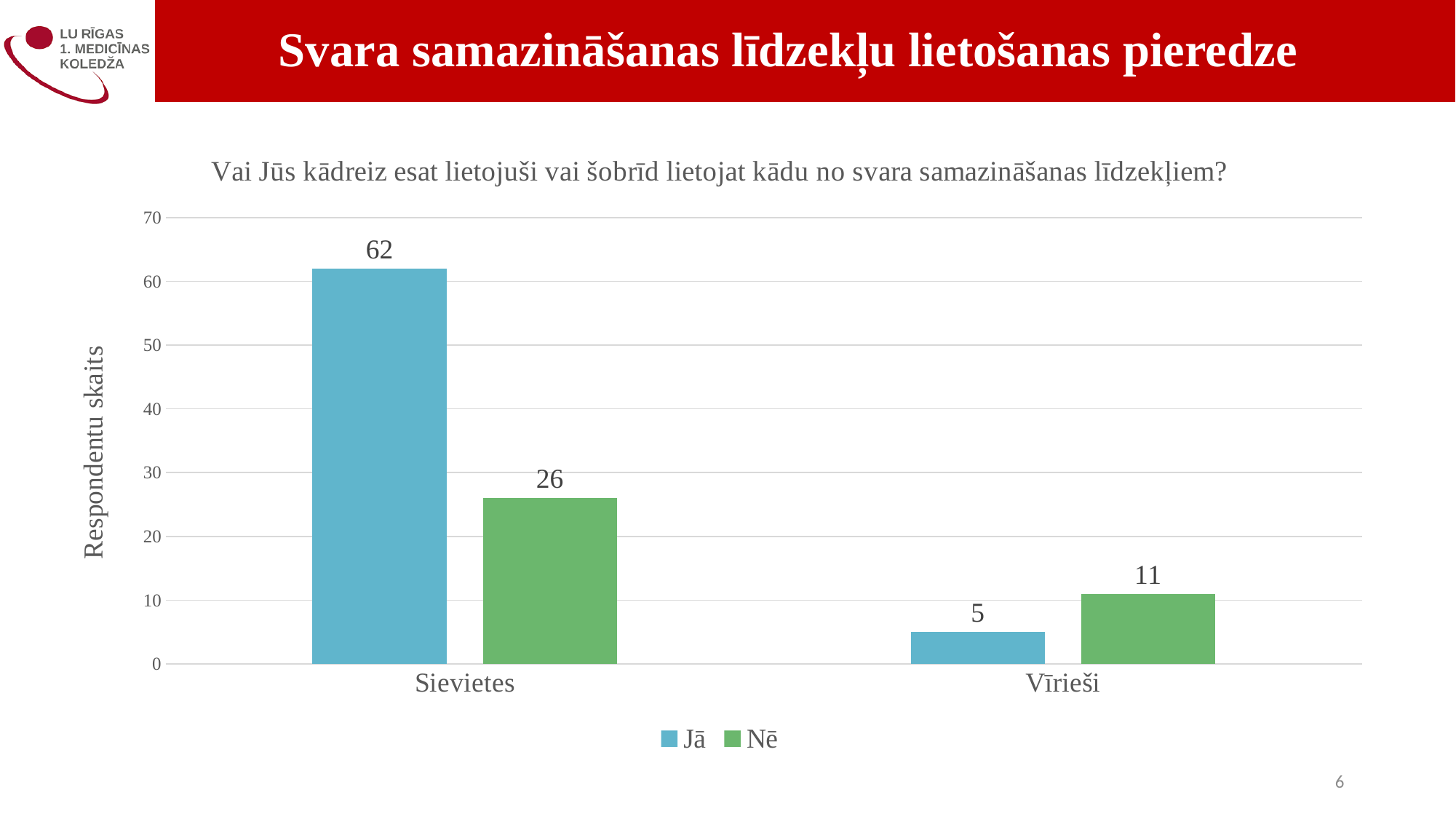
What is the value for Nē in the Vīrieši category? 11 How many series does the legend list? 2 What is the value for Jā in the Vīrieši category? 5 Which category has the highest Jā value? Sievietes What is the label of the vertical axis? Respondentu skaits Which category has the lowest Nē value? Vīrieši How many categories are shown on the x axis? 2 Is the Nē value for Sievietes greater or less than 30? less What is the difference between the Jā and Nē values for Sievietes? 36 Which is larger for Vīrieši, Jā or Nē? Nē What kind of chart is shown on the slide? bar chart What is the value for Jā in the Sievietes category? 62